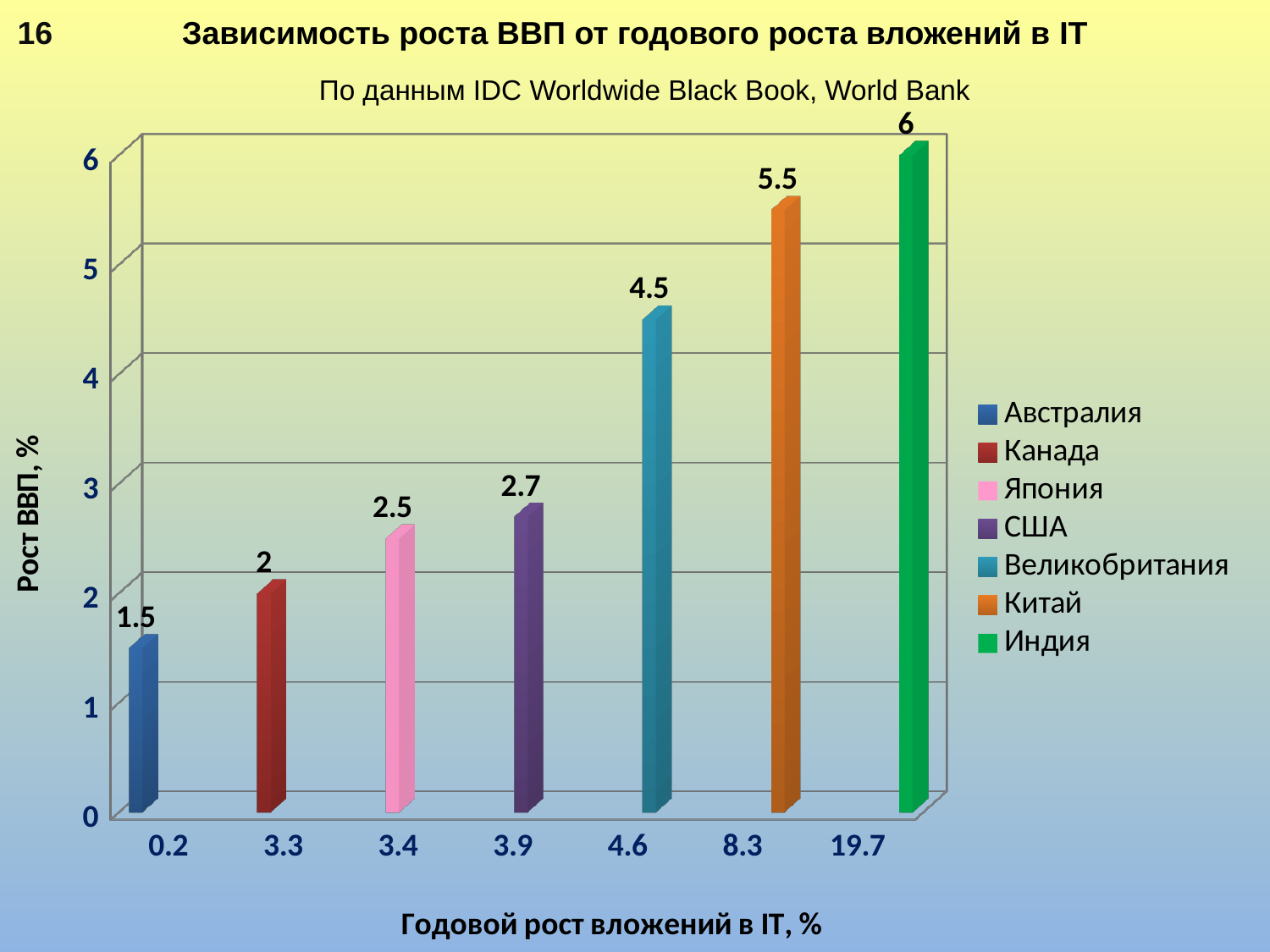
What kind of chart is shown on the slide? Bar chart Which country has the lowest GDP growth value on the chart? Австралия How many entries does the legend list? 7 What is the GDP growth value (Рост ВВП, %) shown for Австралия? 1.5 What is the difference between the GDP growth values for США and Япония? 0.2 What is the GDP growth value shown for Китай? 5.5 Which country has the highest GDP growth value on the chart? Индия What is the difference between the GDP growth values for Индия and Австралия? 4.5 Which has a larger GDP growth value, Канада or Великобритания? Великобритания Do the GDP growth values rise or fall from left to right along the x axis? Rise What is the GDP growth value shown for Великобритания? 4.5 How many bars are plotted on the chart? 7